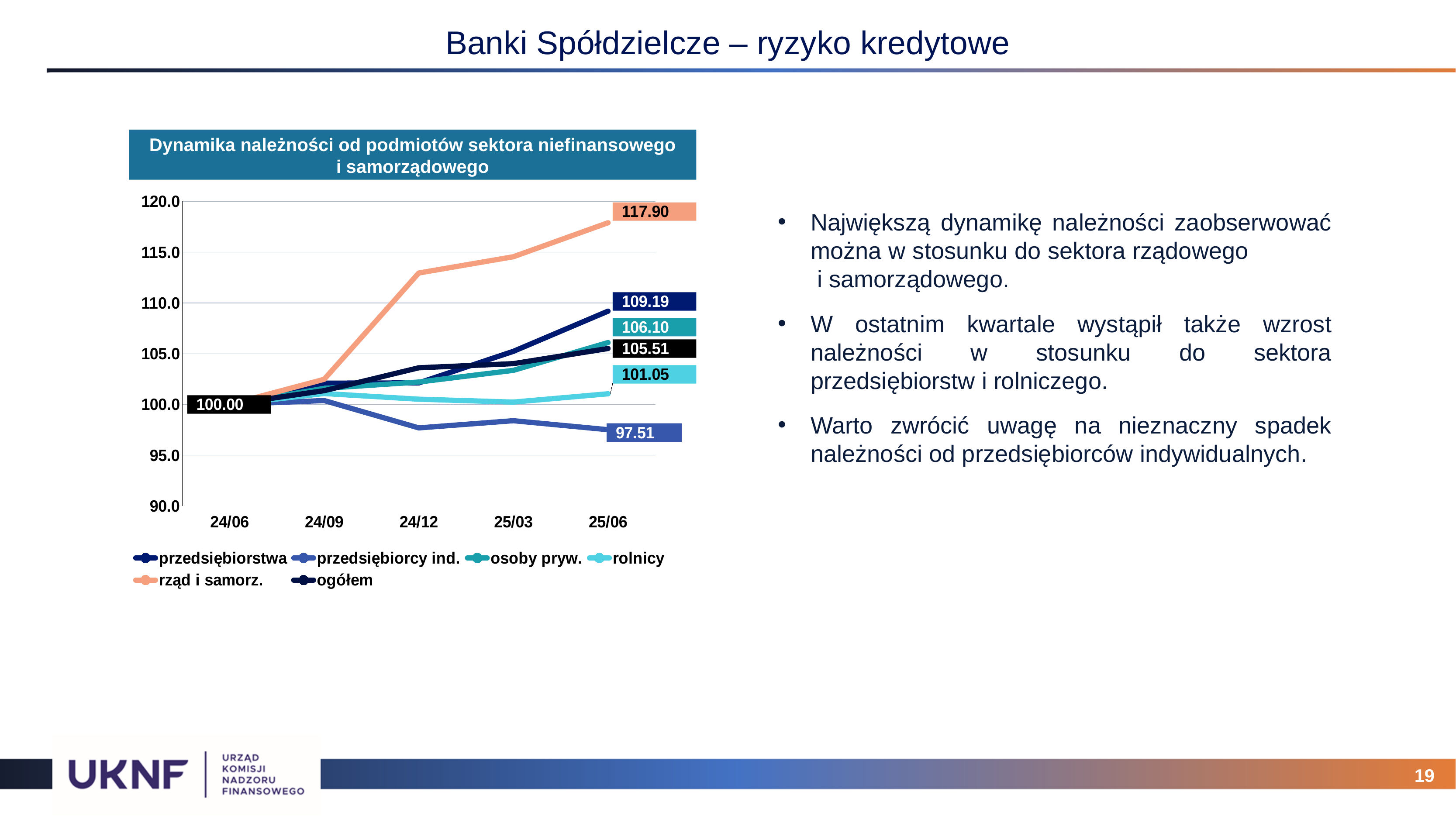
Is the value for rząd i samorz. at 24/12 greater or less than 110.0? greater Does the przedsiębiorcy ind. series rise or fall from 24/06 to 25/06? fall At 25/06, which is larger: osoby pryw. or ogółem? osoby pryw. Which series has the highest value at 25/06? rząd i samorz. What is the difference between the values for rząd i samorz. and przedsiębiorstwa at 25/06? 8.71 How many series does the legend of the chart list? 6 What is the value for przedsiębiorcy ind. at 25/06? 97.51 What is the value for rząd i samorz. at 25/06? 117.90 What is the value for rolnicy at 25/06? 101.05 What kind of chart is shown on the slide? line chart Which series has the lowest value at 25/06? przedsiębiorcy ind. How many time points are shown on the x axis of the chart? 5